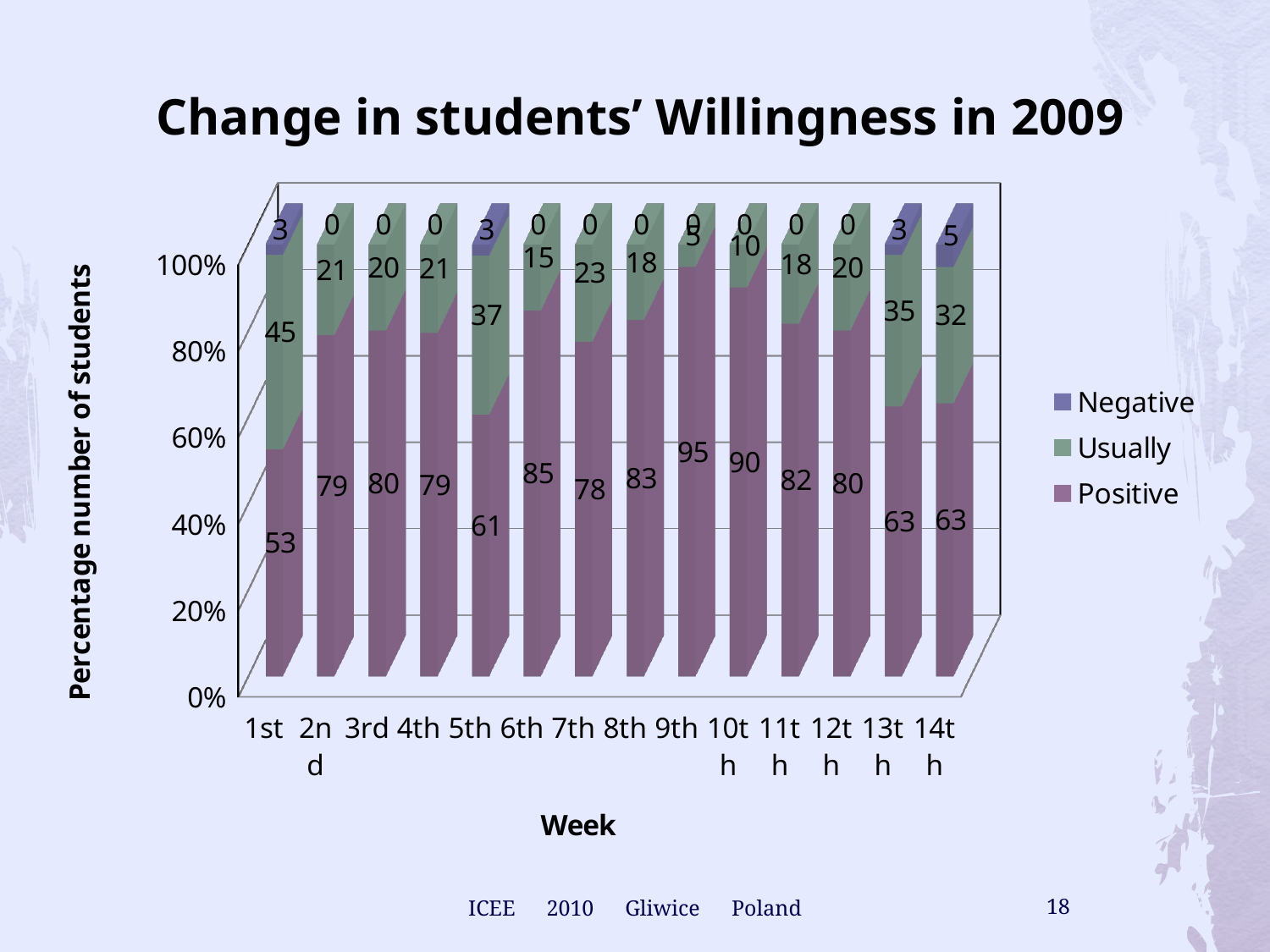
What is the difference between the Positive values for the 2nd week and the 1st week? 26 What kind of chart is shown on the slide? Stacked bar chart Which week has the highest Positive value? 9th Which week has the larger Usually value, the 13th or the 14th? 13th What is the Negative value for the 14th week? 5 Which week has the lowest Positive value? 1st What is the title of the chart? Change in students' Willingness in 2009 How many series does the legend list? 3 What is the Positive value for the 1st week? 53 Which week has the highest Usually value? 1st How many weeks are shown on the x axis? 14 What is the Usually value for the 5th week? 37